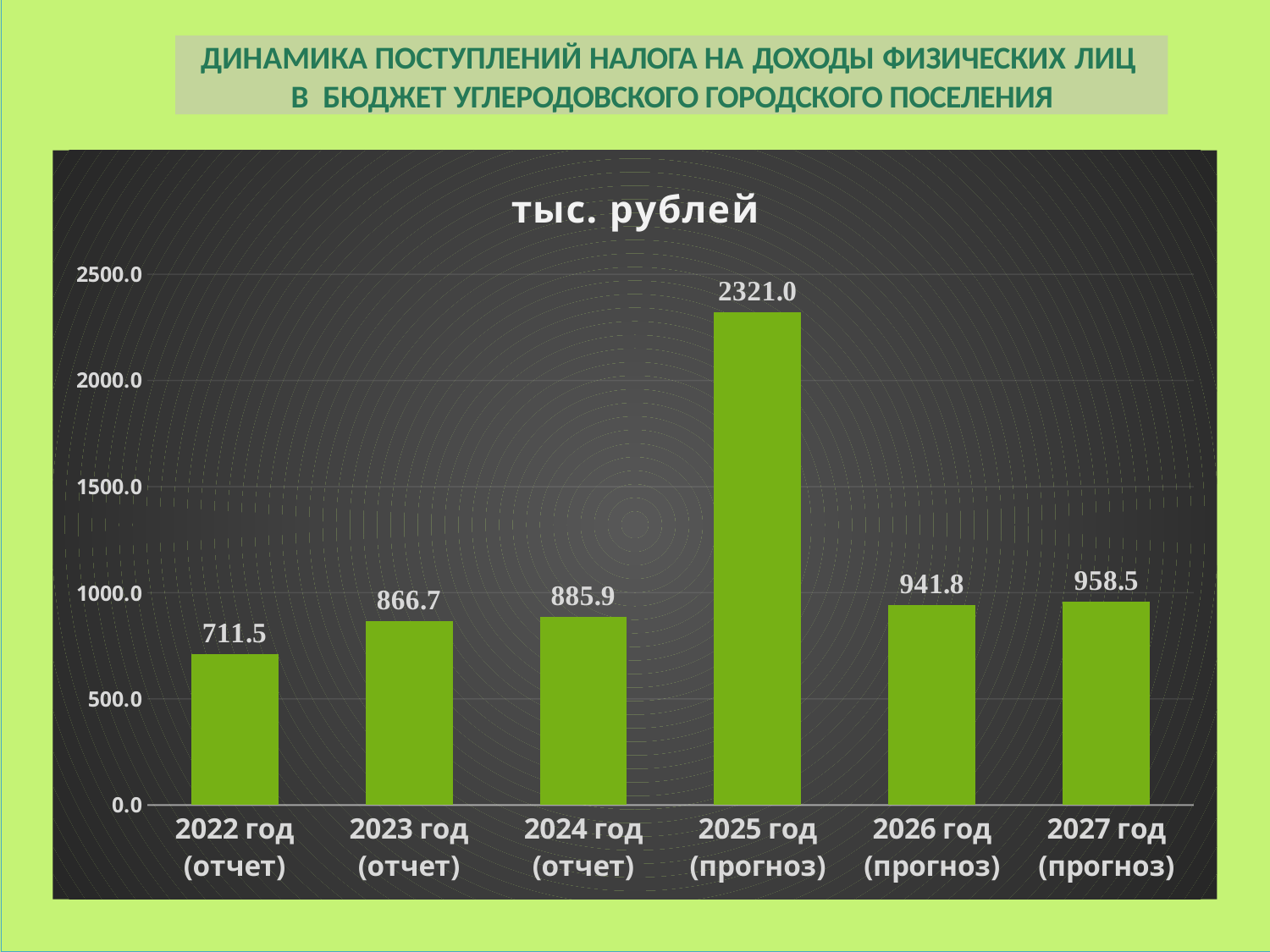
What is the value for 2022 год (отчет)? 711.5 What is the value for 2027 год (прогноз)? 958.5 How many years are shown on the chart? 6 What is the title shown above the chart's plot area? тыс. рублей Which year has the highest value? 2025 год (прогноз) What is the difference between the values for 2025 год (прогноз) and 2024 год (отчет)? 1435.1 What kind of chart is shown on the slide? bar chart Is the value for 2024 год (отчет) greater or less than 1000.0? less What is the difference between the values for 2027 год (прогноз) and 2022 год (отчет)? 247.0 Which is larger, the value for 2026 год (прогноз) or 2023 год (отчет)? 2026 год (прогноз) What is the value for 2025 год (прогноз)? 2321.0 Which year has the lowest value? 2022 год (отчет)